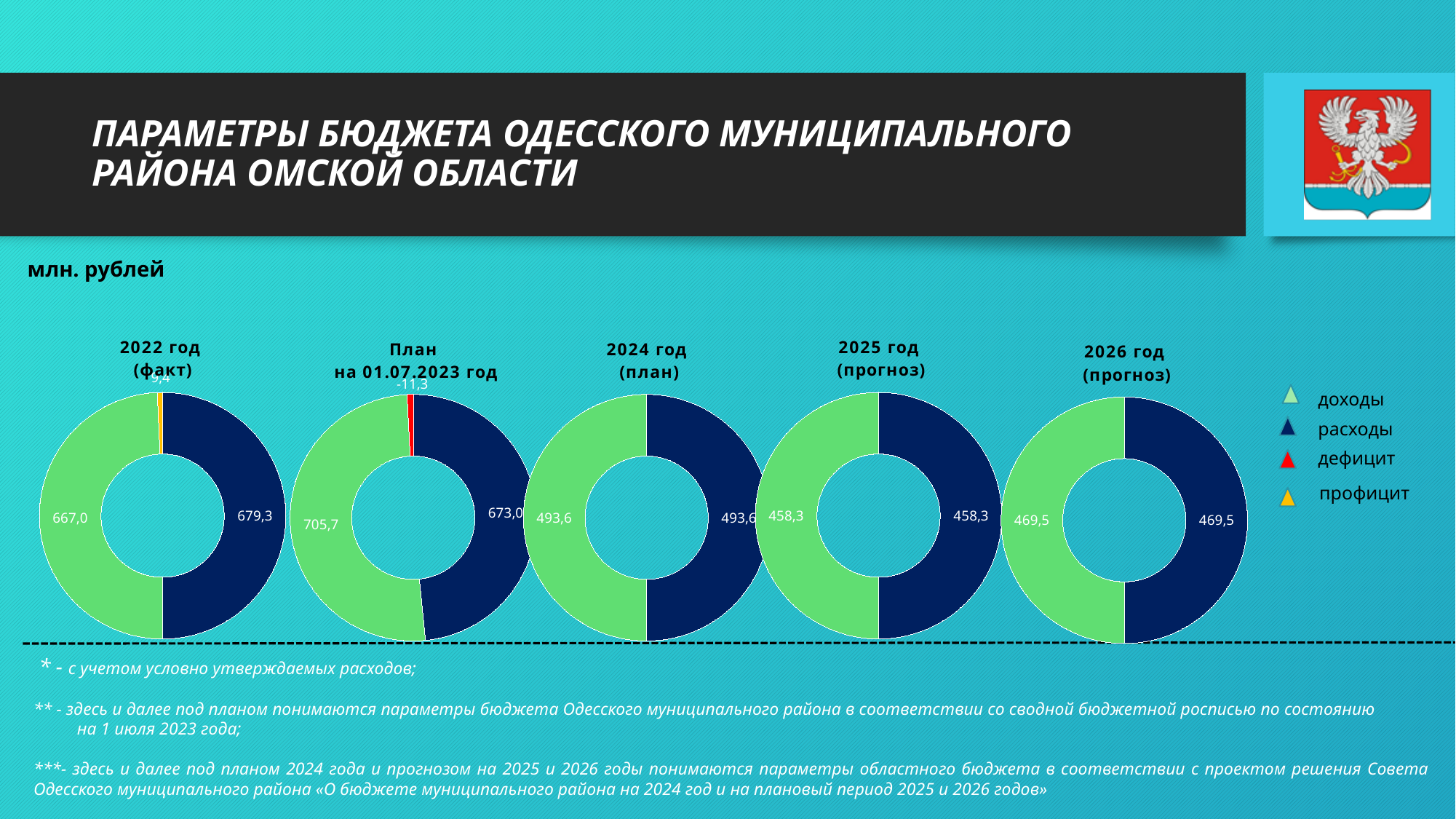
In the '2022 год (факт)' chart, what is the value for расходы? 679,3 In the 'План на 01.07.2023 год' chart, what is the difference between доходы and расходы? 32,7 In the '2025 год (прогноз)' chart, what is the value for доходы? 458,3 In the '2024 год (план)' chart, what is the value for расходы? 493,6 In the '2022 год (факт)' chart, what is the value for доходы? 667,0 In the 'План на 01.07.2023 год' chart, what is the value for расходы? 673,0 How many entries does the legend on the right list? 4 In the '2026 год (прогноз)' chart, what is the value for расходы? 469,5 In the 'План на 01.07.2023 год' chart, what value is shown for the дефицит slice? -11,3 In the '2022 год (факт)' chart, which is larger, доходы or расходы? расходы How many doughnut charts are shown on the slide? 5 In the 'План на 01.07.2023 год' chart, what is the value for доходы? 705,7